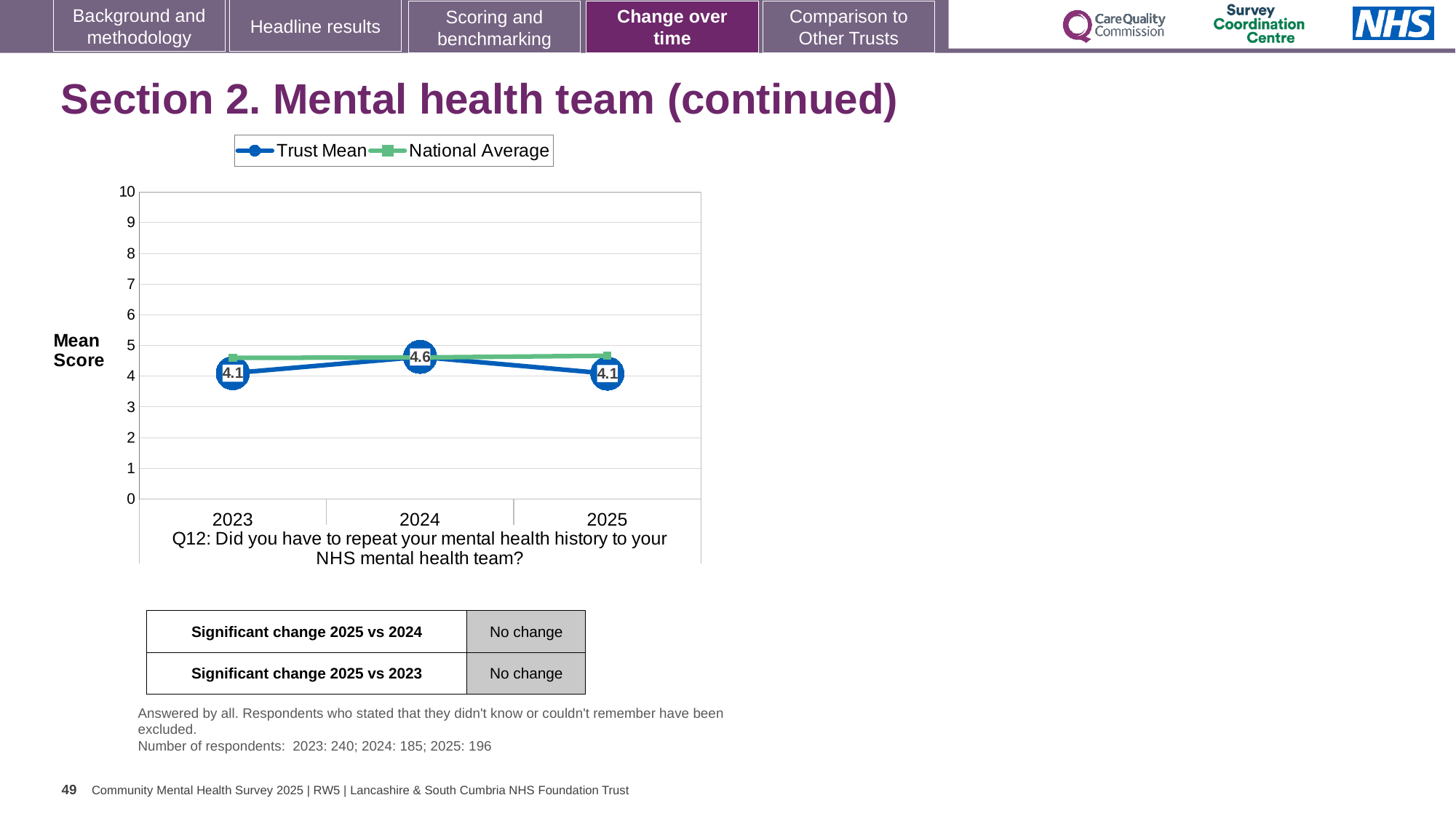
What is the Trust Mean score for 2025? 4.1 In which year is the Trust Mean highest? 2024 What is the Trust Mean score for 2024? 4.6 Is the National Average value for 2023 greater or less than 4? greater What is the difference between the Trust Mean in 2024 and in 2023? 0.5 Is the Trust Mean value for 2024 greater or less than 5? less What kind of chart is shown on the slide? Line chart How many series does the legend list? 2 What is the label on the y axis of the chart? Mean Score How many years are plotted on the x axis? 3 What is the Trust Mean score for 2023? 4.1 Which is larger, the Trust Mean for 2024 or for 2025? 2024